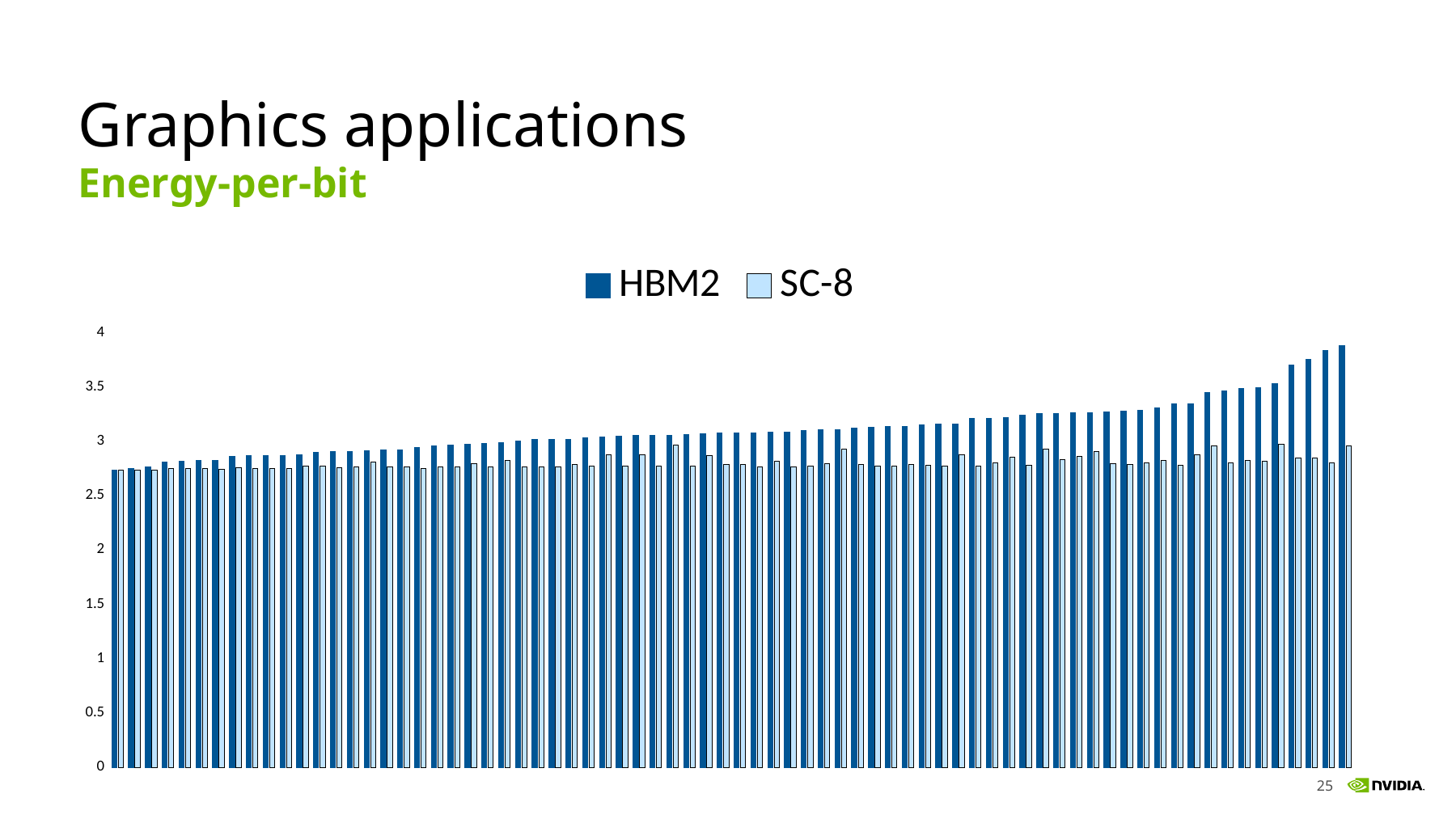
What is the highest value labelled on the y axis? 4 Are all SC-8 bars greater or less than 3.5? less Do the HBM2 values rise or fall from left to right along the x axis? rise What are the two series named in the legend? HBM2 and SC-8 How many series does the legend list? 2 Which series is drawn in dark blue? HBM2 What kind of chart is shown on the slide? bar chart Which series has the highest single bar on the chart? HBM2 Is the value of the leftmost HBM2 bar greater or less than 3? less Is the value of the rightmost HBM2 bar greater or less than 3.5? greater For the rightmost pair of bars, which series has the larger value, HBM2 or SC-8? HBM2